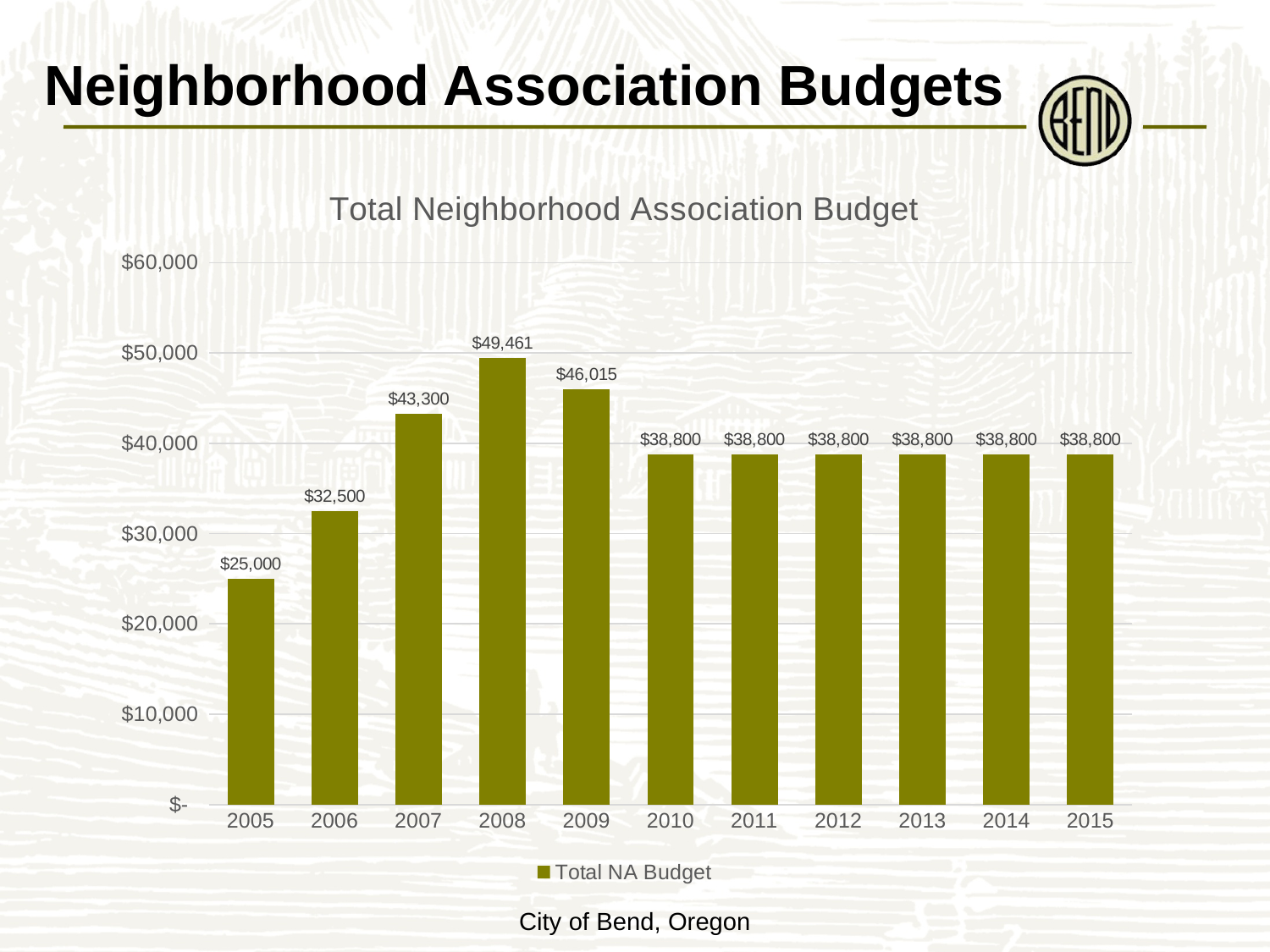
What kind of chart is shown on the slide? Bar chart What is the title of the chart? Total Neighborhood Association Budget What is the Total NA Budget for 2012? $38,800 What is the Total NA Budget for 2005? $25,000 What is the difference between the Total NA Budget in 2007 and in 2006? $10,800 Which year has the highest Total NA Budget? 2008 Is the Total NA Budget for 2009 greater or less than $40,000? greater Which year has the lowest Total NA Budget? 2005 How many years are shown on the x axis of the chart? 11 What is the Total NA Budget for 2008? $49,461 What is the difference between the Total NA Budget in 2008 and in 2009? $3,446 Which year has a larger Total NA Budget, 2007 or 2010? 2007